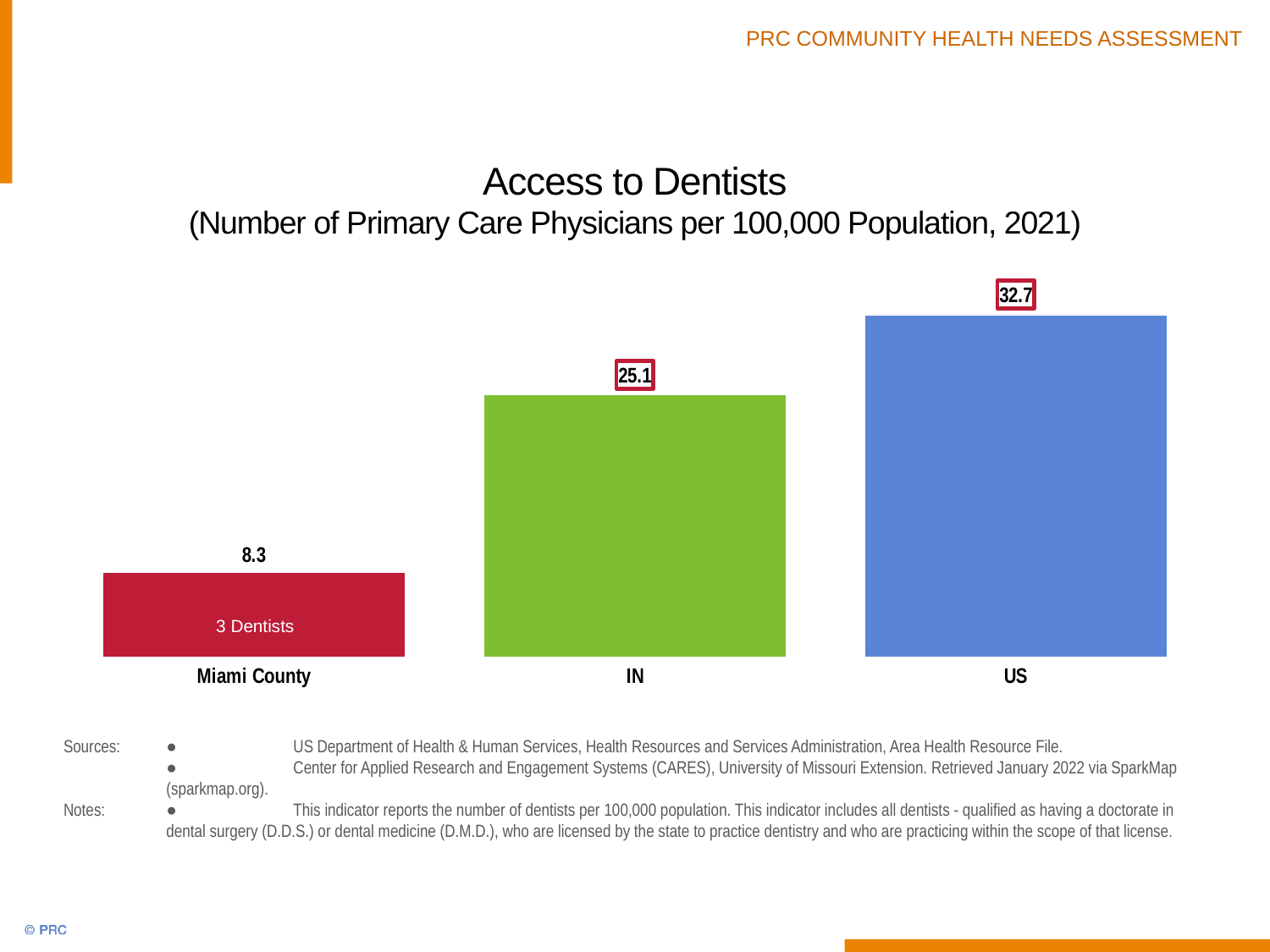
What text is printed inside the Miami County bar? 3 Dentists What is the difference between the US value and the Miami County value? 24.4 How many categories are shown in the chart? 3 What is the value for Miami County? 8.3 Do the values rise or fall from left to right across the categories? Rise Which category has the lowest value? Miami County What is the difference between the IN value and the Miami County value? 16.8 What is the value for US? 32.7 Which category has the highest value? US Which is larger, the value for IN or the value for US? US What is the value for IN? 25.1 What kind of chart is shown on the slide? Bar chart